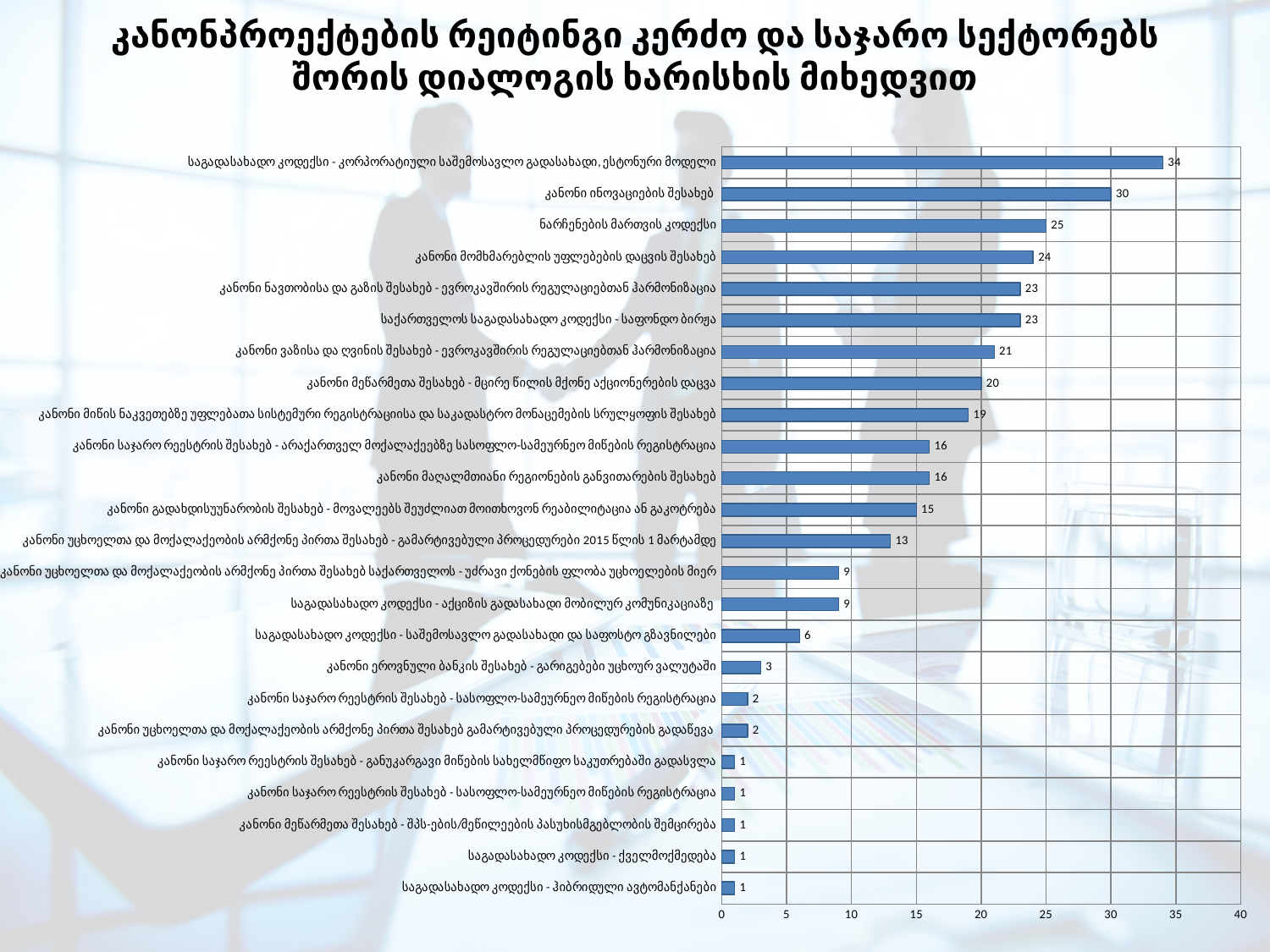
Which category has the highest value? საგადასახადო კოდექსი - კორპორატიული საშემოსავლო გადასახადი, ესტონური მოდელი Which has a larger value: "კანონი ვაზისა და ღვინის შესახებ - ევროკავშირის რეგულაციებთან ჰარმონიზაცია" or "კანონი მეწარმეთა შესახებ - მცირე წილის მქონე აქციონერების დაცვა"? კანონი ვაზისა და ღვინის შესახებ - ევროკავშირის რეგულაციებთან ჰარმონიზაცია What is the value for "კანონი ეროვნული ბანკის შესახებ - გარიგებები უცხოურ ვალუტაში"? 3 What is the value for "კანონი მაღალმთიანი რეგიონების განვითარების შესახებ"? 16 What is the value for "ნარჩენების მართვის კოდექსი"? 25 Is the value for "კანონი გადახდისუუნარობის შესახებ - მოვალეებს შეუძლიათ მოითხოვონ რეაბილიტაცია ან გაკოტრება" greater or less than 20? less How many categories are plotted on the chart? 24 What is the difference between the values for "კანონი ინოვაციების შესახებ" and "კანონი მომხმარებლის უფლებების დაცვის შესახებ"? 6 What is the maximum value shown on the horizontal axis? 40 What is the lowest value shown on the chart? 1 What type of chart is shown on the slide? bar chart What is the value for "კანონი ინოვაციების შესახებ"? 30